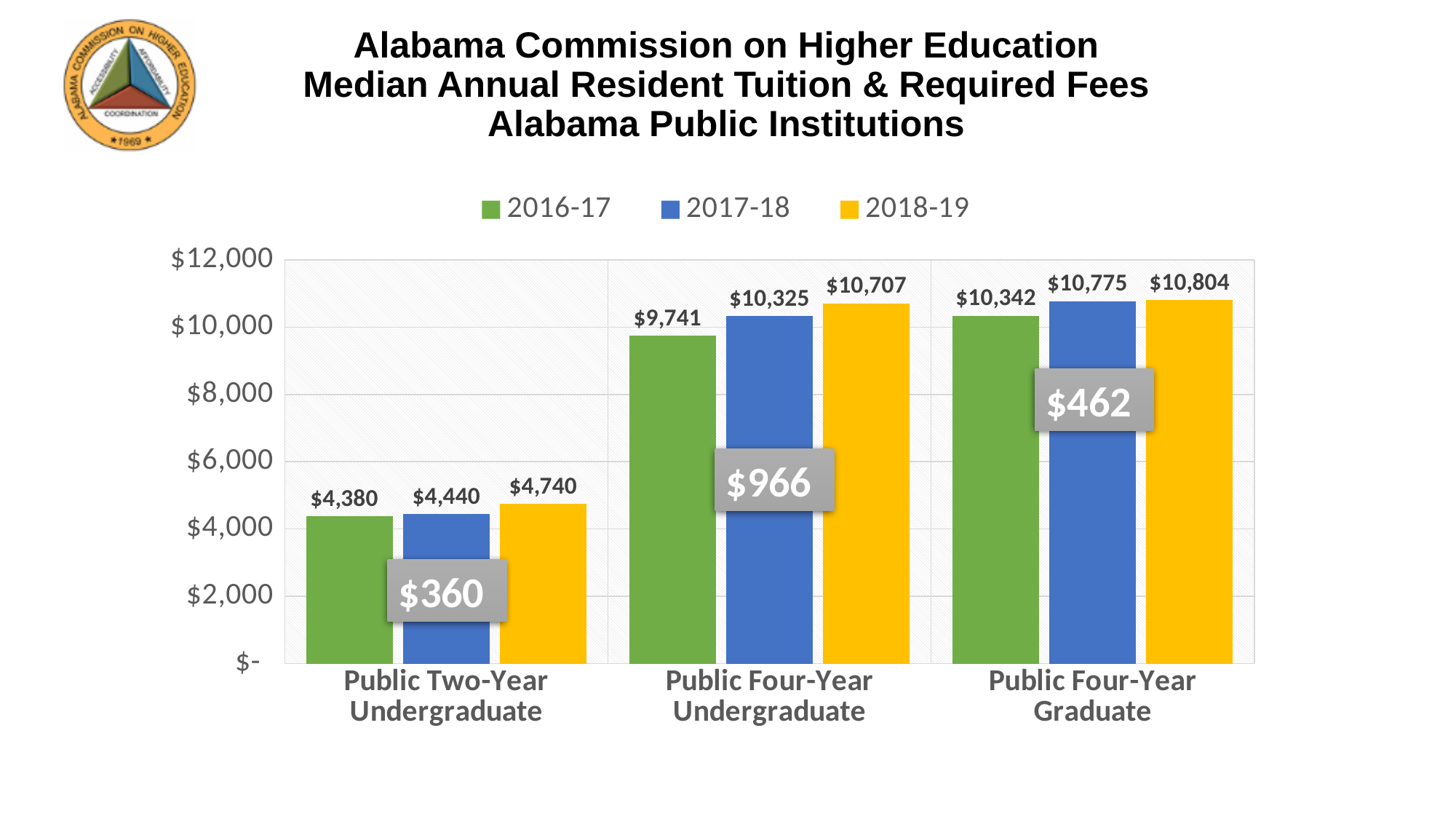
What is the 2018-19 value for Public Two-Year Undergraduate? $4,740 What is the 2016-17 value for Public Four-Year Undergraduate? $9,741 What is the difference between the 2018-19 and 2016-17 values for Public Four-Year Undergraduate? $966 How many series does the legend list? 3 Which category has the lowest 2016-17 value? Public Two-Year Undergraduate What is the 2017-18 value for Public Four-Year Graduate? $10,775 Which colour represents the 2017-18 series? Blue Which is larger: the 2017-18 value for Public Four-Year Undergraduate or the 2016-17 value for Public Four-Year Graduate? 2016-17 value for Public Four-Year Graduate What kind of chart is shown on the slide? Bar chart How many categories are shown on the x axis? 3 What is the difference between the 2017-18 and 2016-17 values for Public Two-Year Undergraduate? $60 Which category has the highest 2018-19 value? Public Four-Year Graduate